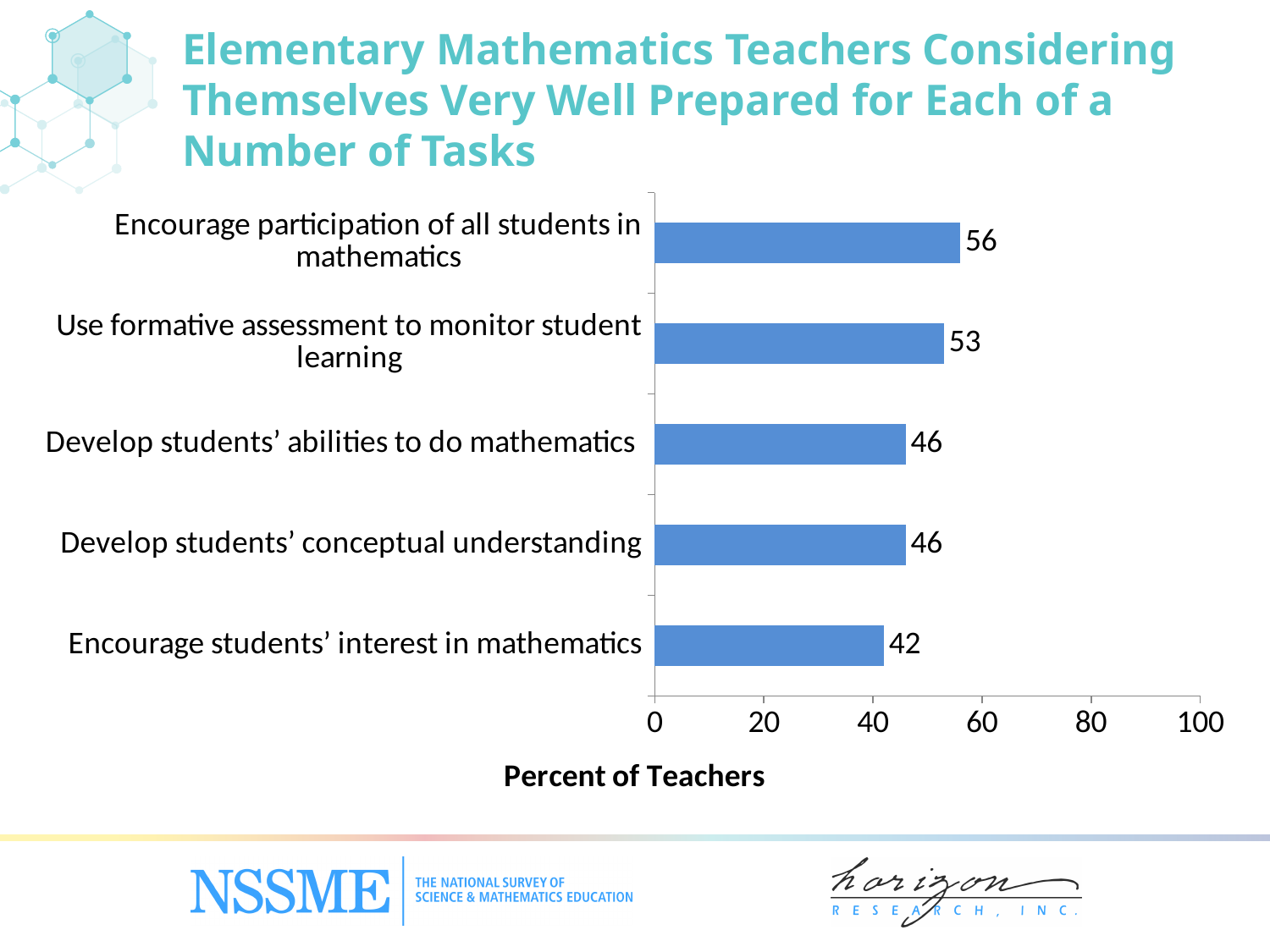
What kind of chart is shown on the slide? Bar chart What is the difference between the values for 'Encourage participation of all students in mathematics' and 'Encourage students' interest in mathematics'? 14 How many tasks are shown in the chart? 5 What is the value for 'Use formative assessment to monitor student learning'? 53 What is the value for 'Encourage students' interest in mathematics'? 42 Which is larger: the value for 'Use formative assessment to monitor student learning' or 'Develop students' abilities to do mathematics'? Use formative assessment to monitor student learning What is the label of the horizontal axis? Percent of Teachers Is the value for 'Develop students' conceptual understanding' greater or less than 60? less Which task has the highest percent of teachers? Encourage participation of all students in mathematics Which task has the lowest percent of teachers? Encourage students' interest in mathematics What is the difference between the values for 'Use formative assessment to monitor student learning' and 'Develop students' conceptual understanding'? 7 What percent of teachers consider themselves very well prepared to encourage participation of all students in mathematics? 56